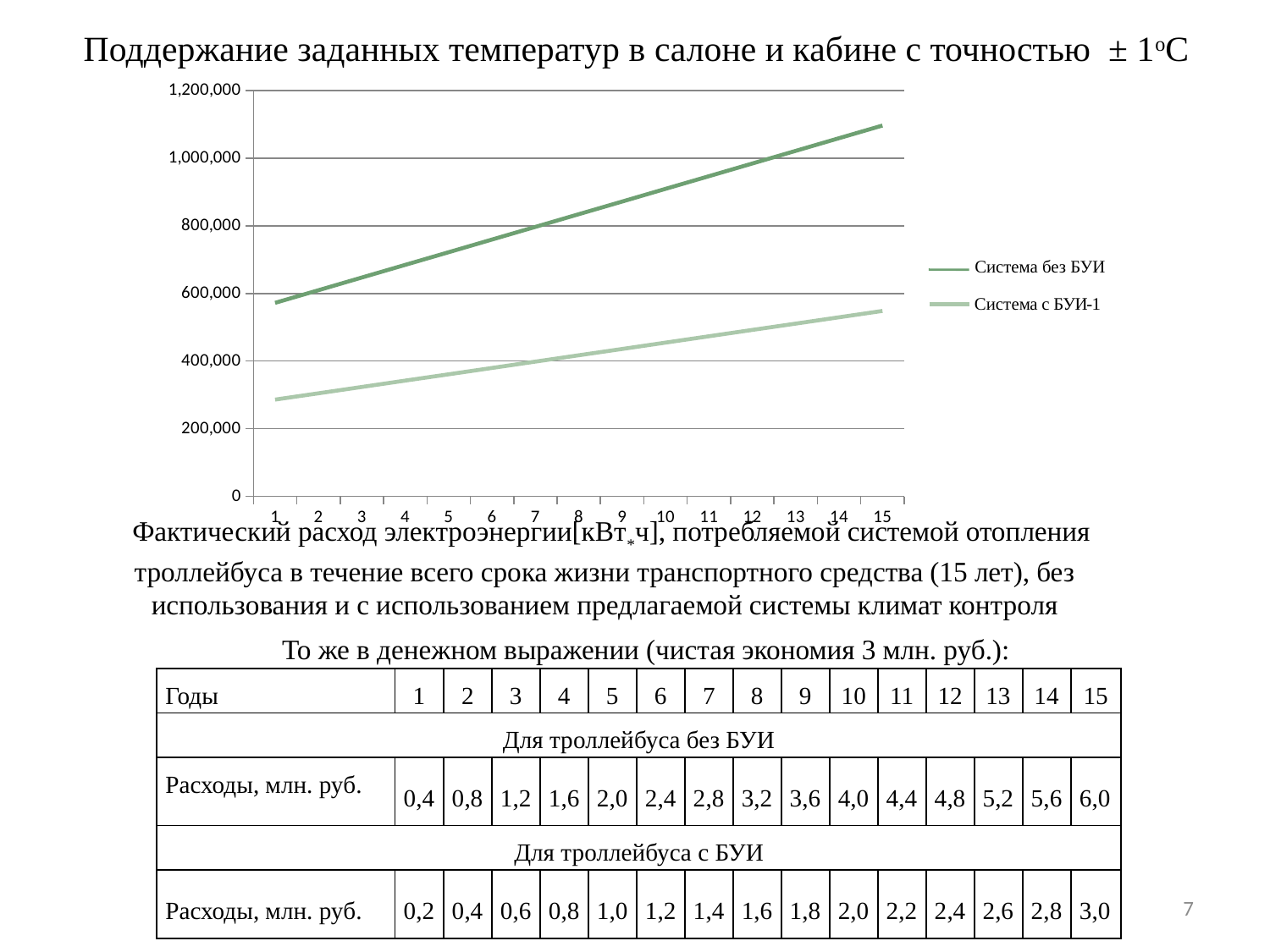
Which series has the higher value at year 15, "Система без БУИ" or "Система с БУИ-1"? Система без БУИ Is the value for "Система с БУИ-1" at year 15 greater or less than 600,000? less Do the values for "Система без БУИ" rise or fall from year 1 to year 15? rise Which series lies lower on the chart across all years? Система с БУИ-1 Do the values for "Система с БУИ-1" rise or fall along the x axis? rise Is the value for "Система без БУИ" at year 15 greater or less than 1,000,000? greater How many series does the chart legend list? 2 What are the two legend entries of the chart? Система без БУИ; Система с БУИ-1 Is the value for "Система с БУИ-1" at year 1 greater or less than 400,000? less How many points along the x axis does each line in the chart cover? 15 What kind of chart is shown on the slide? line chart